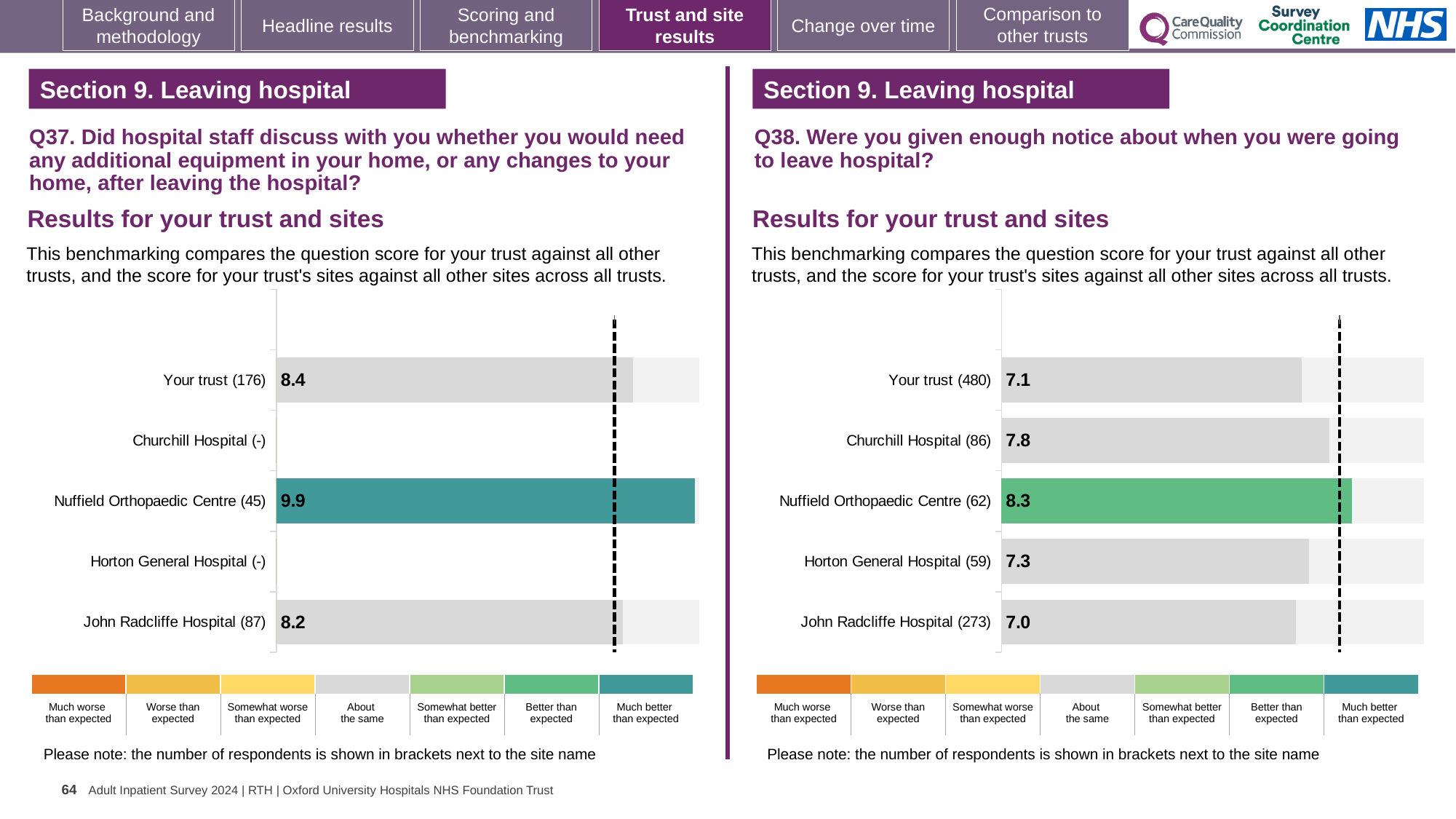
How many sites or rows are listed in the Q37 chart on the left? 5 In the Q38 chart on the right, which has the higher score, Horton General Hospital or Your trust? Horton General Hospital In the Q38 chart on the right, what is the score for John Radcliffe Hospital? 7.0 In the Q38 chart on the right, which site has the lowest score? John Radcliffe Hospital In the Q38 chart on the right, what is the difference between the scores for Churchill Hospital and Your trust? 0.7 In the Q37 chart on the left, how many respondents are shown in brackets for Your trust? 176 In the Q38 chart on the right, what is the score for Churchill Hospital? 7.8 In the Q37 chart on the left, what is the score for Your trust? 8.4 In the Q38 chart on the right, which site has the highest score? Nuffield Orthopaedic Centre In the Q37 chart on the left, what is the difference between the scores for Nuffield Orthopaedic Centre and John Radcliffe Hospital? 1.7 What kind of chart is used for the Q38 results on the right? Bar chart In the Q37 chart on the left, what is the score for Nuffield Orthopaedic Centre? 9.9